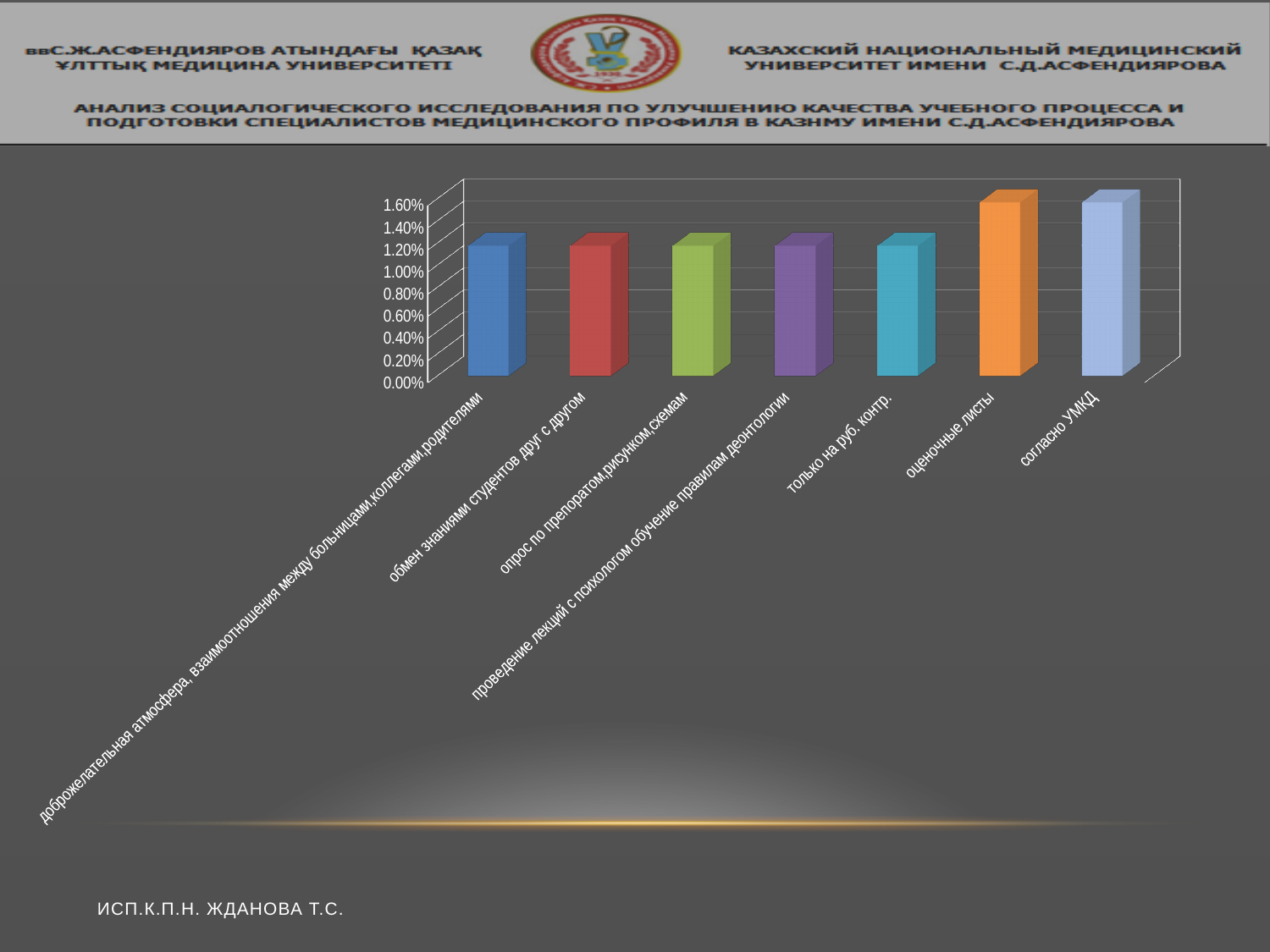
Is the value for "обмен знаниями студентов друг с другом" greater or less than 1.00%? greater Which is larger: the value for "согласно УМКД" or the value for "обмен знаниями студентов друг с другом"? согласно УМКД How many categories (bars) does the chart show? 7 Is the value for "только на руб. контр." greater or less than 1.40%? less What is the highest value shown on the vertical axis of the chart? 1.60% Which is larger: the value for "оценочные листы" or the value for "только на руб. контр."? оценочные листы Is the value for "проведение лекций с психологом обучение правилам деонтологии" greater or less than 0.80%? greater What kind of chart is shown on the slide? bar chart What is the label of the first (leftmost) category on the chart? доброжелательная атмосфера, взаимоотношения между больницами,коллегами,родителями